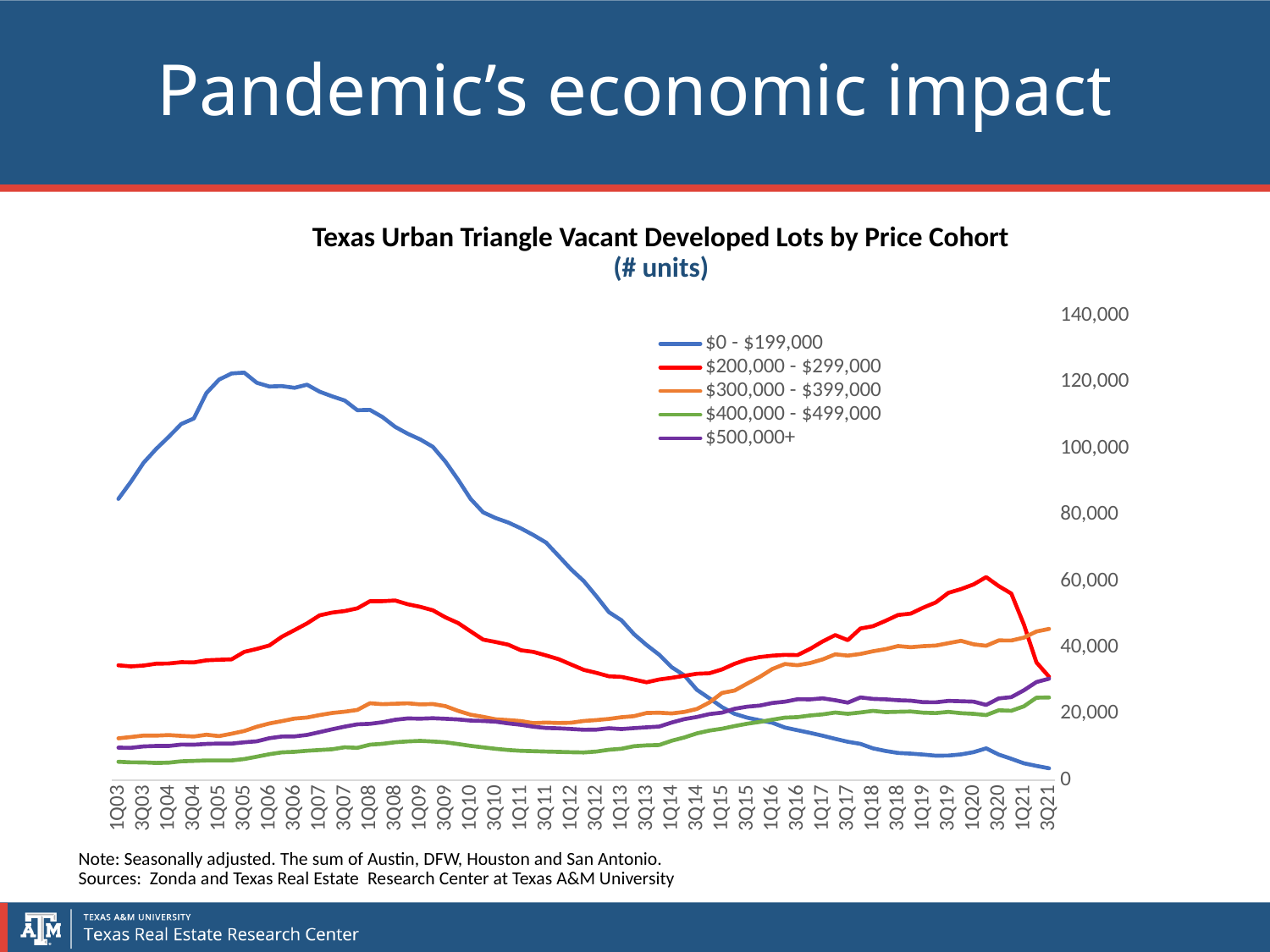
Is the value for $0 - $199,000 at 3Q05 greater or less than 100,000? greater Which price cohort has the lowest value at 1Q03? $400,000 - $499,000 Does the $0 - $199,000 series rise or fall from 3Q05 to 3Q21? fall What kind of chart is shown on the slide? line chart Does the $300,000 - $399,000 series rise or fall from 1Q15 to 3Q21? rise Which price cohort has the highest value at 3Q21? $300,000 - $399,000 Which price cohort has the highest value at 1Q05? $0 - $199,000 Is the value for $0 - $199,000 at 3Q21 greater or less than 20,000? less At 3Q21, which is larger: $300,000 - $399,000 or $200,000 - $299,000? $300,000 - $399,000 How many series does the legend list? 5 Is the value for $200,000 - $299,000 at 1Q20 greater or less than 40,000? greater